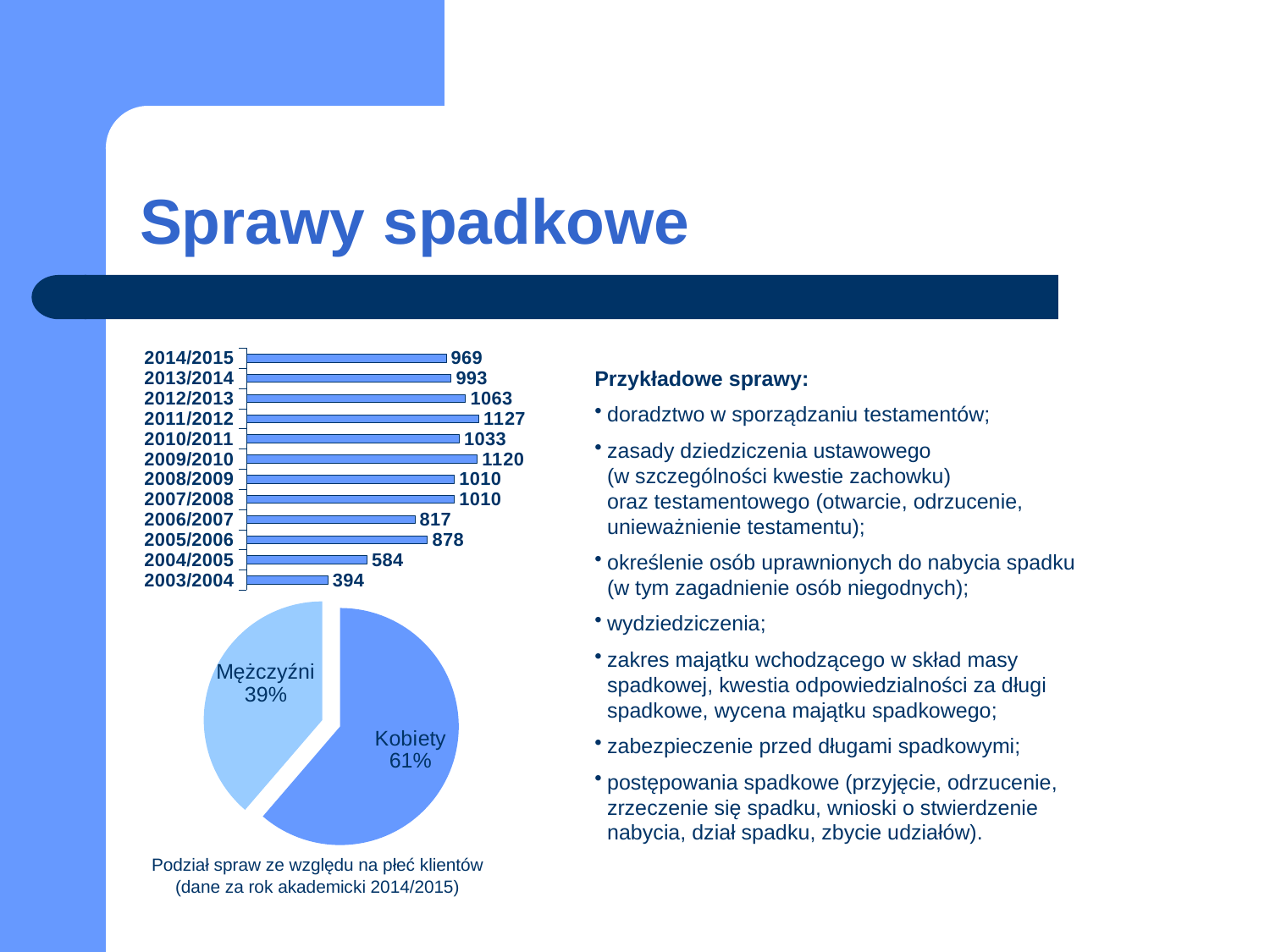
In the bar chart on the left of the slide, what is the value for 2014/2015? 969 In the pie chart on the slide, what share is labelled Kobiety? 61% In the bar chart on the left of the slide, which academic year has the lowest value? 2003/2004 In the bar chart on the left of the slide, which is larger, the value for 2005/2006 or the value for 2006/2007? 2005/2006 In the bar chart on the left of the slide, what is the difference between the values for 2009/2010 and 2010/2011? 87 What kind of chart is the chart at the top left of the slide? bar chart In the bar chart on the left of the slide, what is the value for 2003/2004? 394 In the bar chart on the left of the slide, which academic year has the highest value? 2011/2012 In the pie chart on the slide, what share is labelled Mężczyźni? 39% In the bar chart on the left of the slide, what is the value for 2011/2012? 1127 How many slices does the pie chart on the slide have? 2 How many academic years are shown in the bar chart on the left of the slide? 12